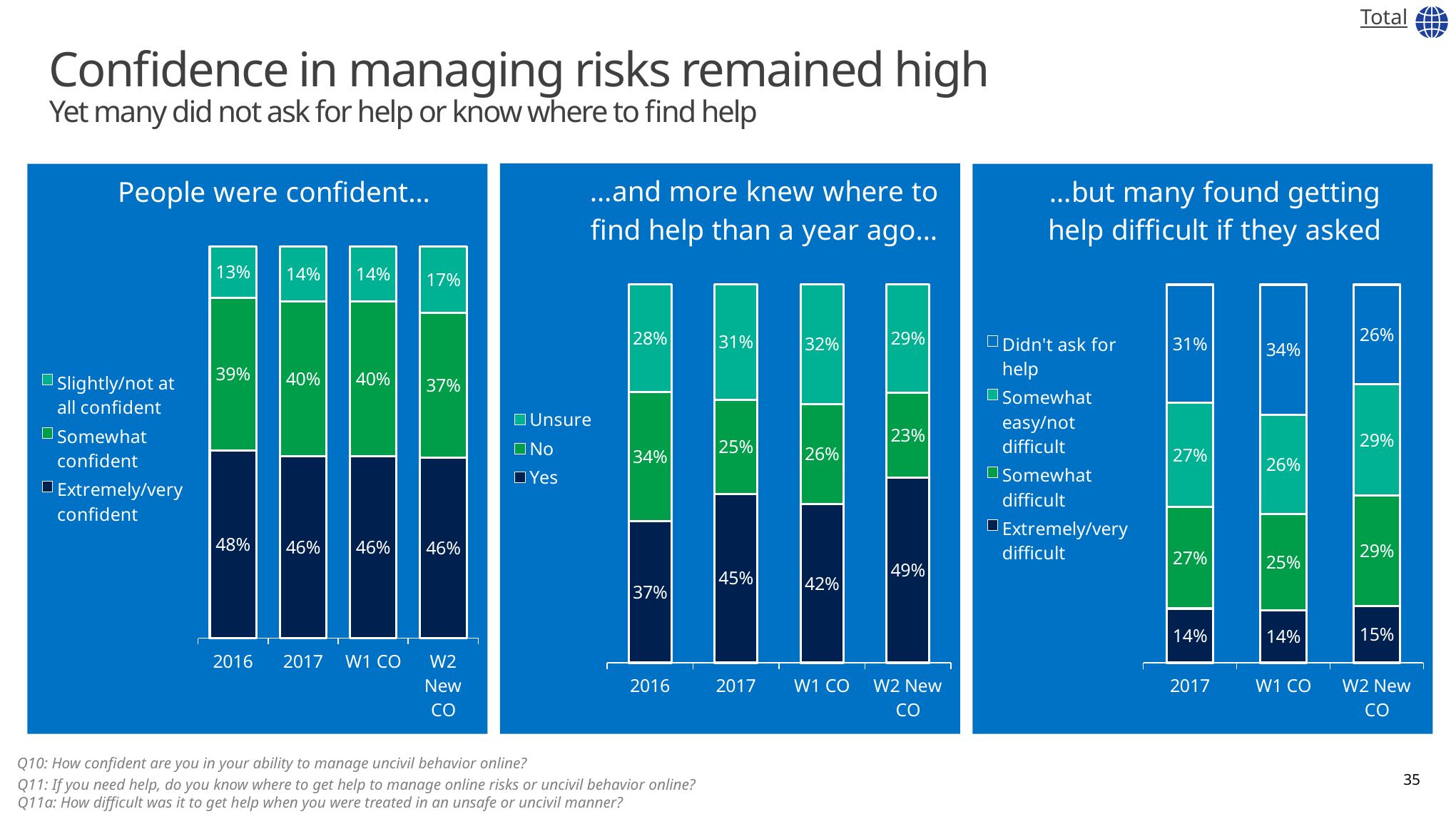
In the chart titled '...and more knew where to find help than a year ago...', which category has the lowest Yes value? 2016 In the chart titled '...but many found getting help difficult if they asked', how many series does the legend list? 4 In the chart titled '...but many found getting help difficult if they asked', what is the value for Didn't ask for help for W1 CO? 34% In the chart titled 'People were confident...', what is the value for Extremely/very confident in 2016? 48% In the chart titled 'People were confident...', what is the value for Slightly/not at all confident for W2 New CO? 17% In the chart titled '...but many found getting help difficult if they asked', how many categories are shown on the x axis? 3 In the chart titled 'People were confident...', is the Somewhat confident value for 2017 larger or smaller than for W2 New CO? larger In the chart titled '...and more knew where to find help than a year ago...', what is the value for Yes for W2 New CO? 49% In the chart titled '...and more knew where to find help than a year ago...', what is the difference between the Yes values for 2017 and 2016? 8% In the chart titled '...but many found getting help difficult if they asked', which category has the highest Extremely/very difficult value? W2 New CO What kind of chart is the chart titled '...and more knew where to find help than a year ago...'? stacked bar chart In the chart titled 'People were confident...', what is the total of the stacked bar for 2016? 100%